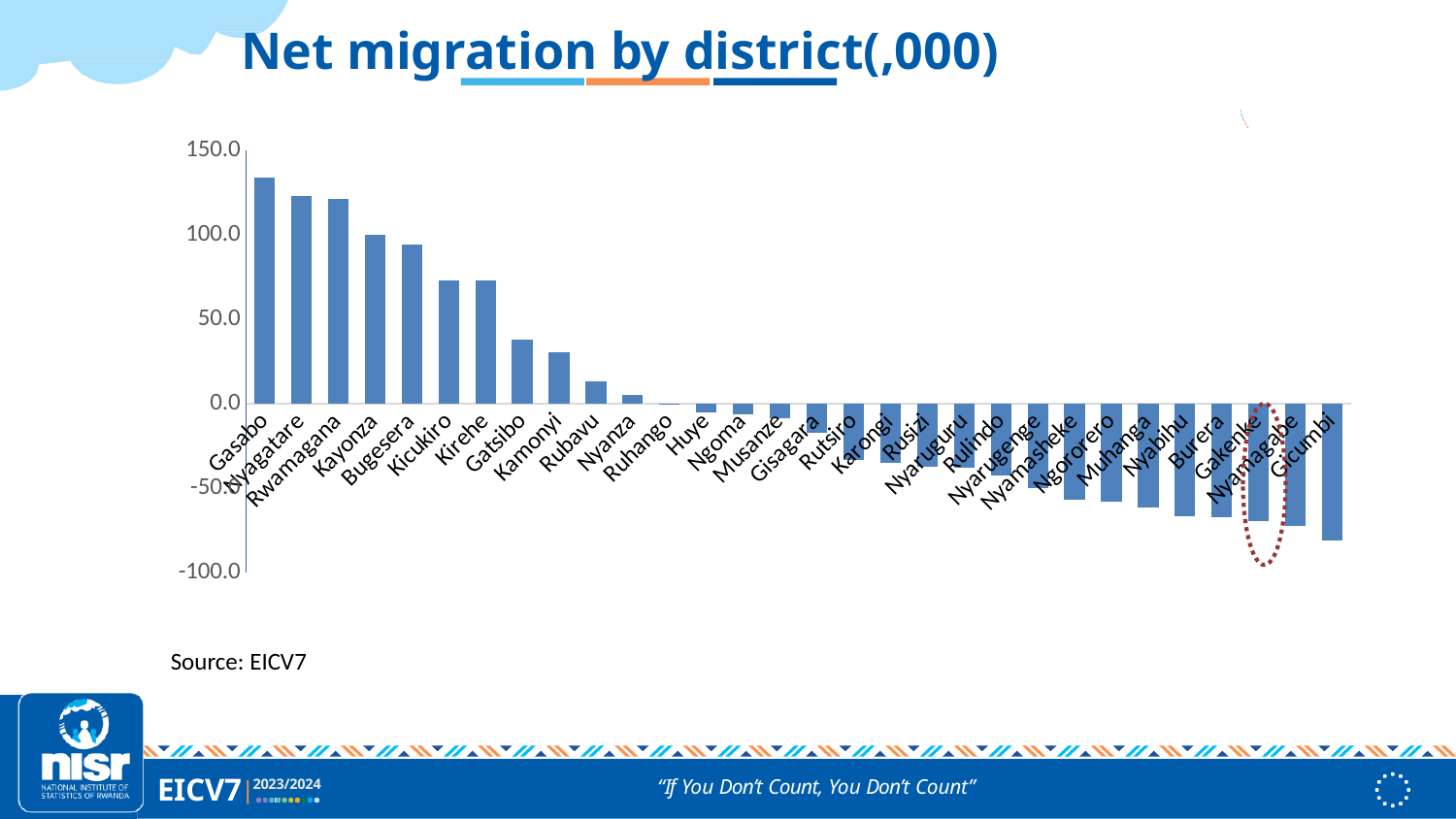
Which district has the lowest net migration? Gicumbi What type of chart is shown on the slide? Bar chart Is the value for Gicumbi greater or less than -50.0? less Which has the larger net migration, Gasabo or Nyagatare? Gasabo Which district has the highest net migration? Gasabo Is the value for Kicukiro greater or less than 50.0? greater How many districts are shown on the x axis of the chart? 30 What is the title of the chart? Net migration by district(,000) Is the value for Bugesera greater or less than 100.0? less Do the values generally rise or fall moving from left to right along the x axis? fall